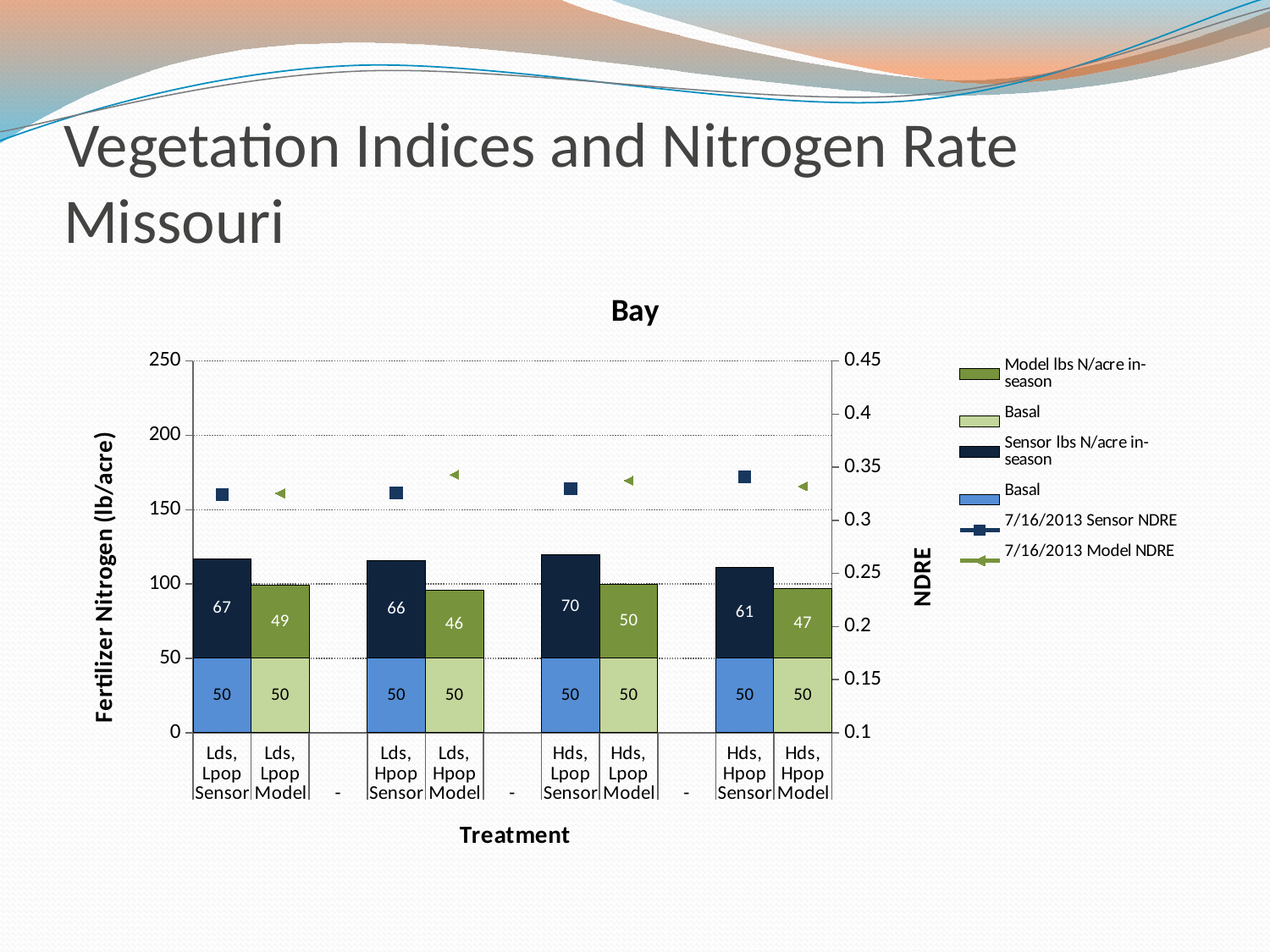
What is the total fertilizer nitrogen for the Lds, Lpop Sensor stacked bar? 117 Which treatment has the lowest Model lbs N/acre in-season value? Lds, Hpop Model Which is larger: the Model in-season value for Lds, Lpop Model or for Hds, Lpop Model? Hds, Lpop Model What is the total fertilizer nitrogen for the Hds, Hpop Model stacked bar? 97 How many entries does the legend list? 6 Which treatment has the highest Sensor lbs N/acre in-season value? Hds, Lpop Sensor What is the Sensor lbs N/acre in-season value for the Lds, Lpop Sensor treatment? 67 What is the title of the chart? Bay What is the Model lbs N/acre in-season value for the Hds, Hpop Model treatment? 47 What is the Basal value for the Lds, Hpop Sensor treatment? 50 What is the difference between the Sensor in-season value for Hds, Lpop Sensor and the Sensor in-season value for Hds, Hpop Sensor? 9 Is the 7/16/2013 Sensor NDRE value for Lds, Lpop Sensor greater or less than 0.3? greater